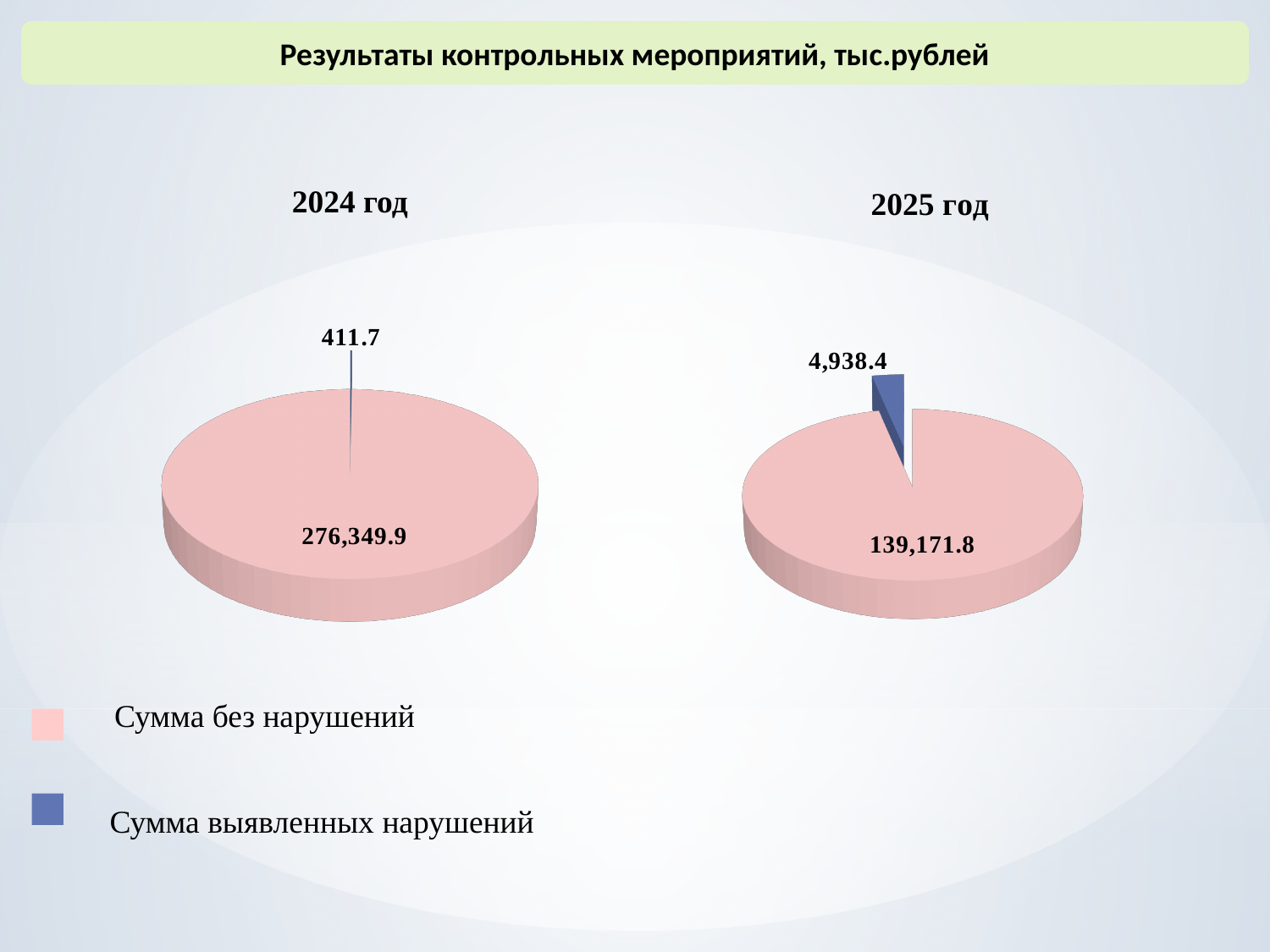
In the 2024 год chart, what is the difference between Сумма без нарушений and Сумма выявленных нарушений? 275,938.2 What colour represents Сумма выявленных нарушений in the legend? Blue In the 2024 год chart, which category has the smallest slice? Сумма выявленных нарушений In the 2024 год chart, what is the value for Сумма выявленных нарушений? 411.7 In the 2025 год chart, what is the value for Сумма без нарушений? 139,171.8 Which is larger: Сумма выявленных нарушений in the 2024 год chart or in the 2025 год chart? 2025 год In the 2025 год chart, what is the value for Сумма выявленных нарушений? 4,938.4 In the 2025 год chart, what is the total of the two slices? 144,110.2 What type of chart is used for the 2024 год and 2025 год data? Pie chart In the 2025 год chart, which category has the largest slice? Сумма без нарушений How many slices does the 2025 год pie chart have? 2 In the 2024 год chart, what is the value for Сумма без нарушений? 276,349.9